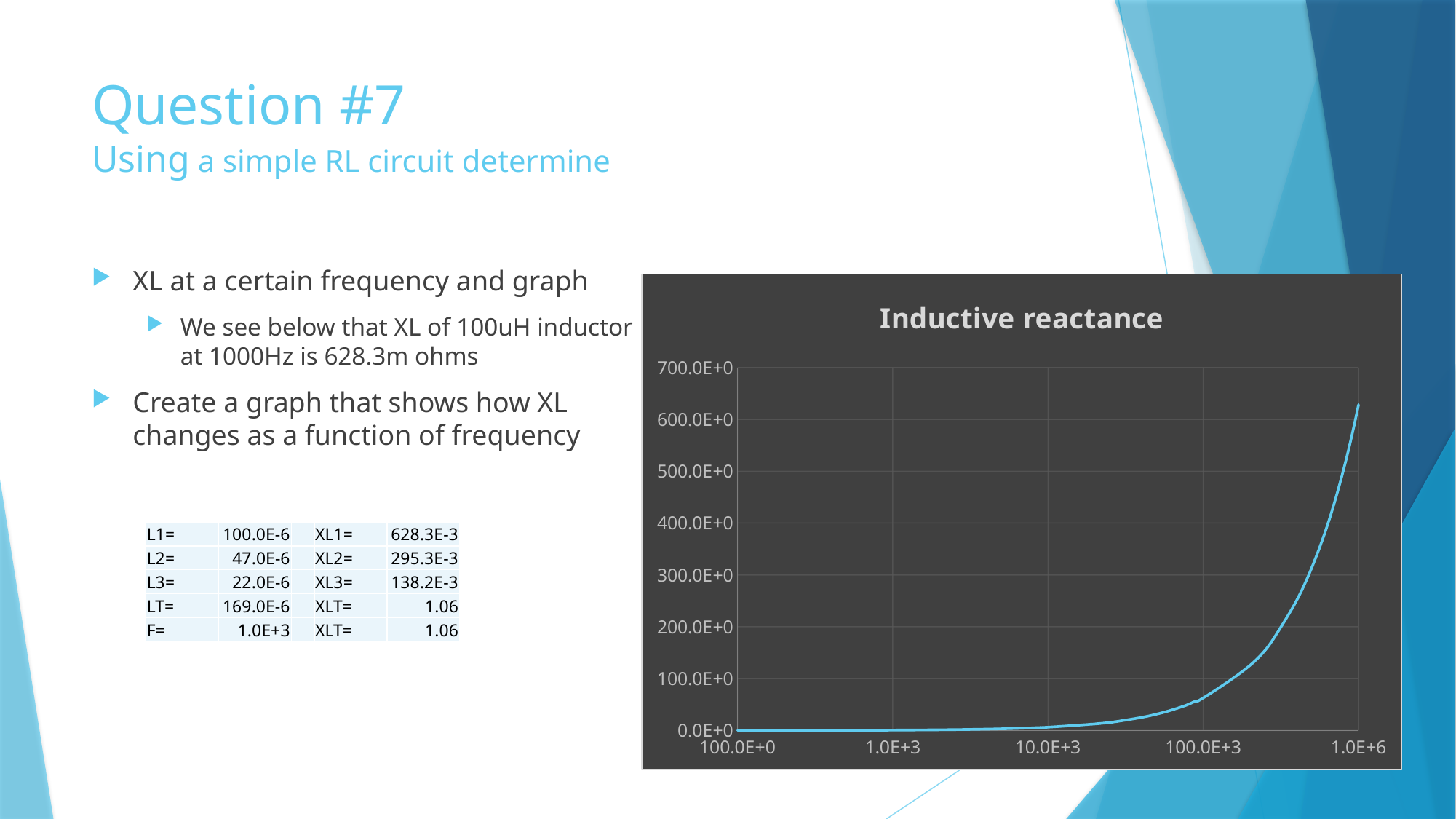
Is the value at 1.0E+6 on the x axis greater or less than 500.0E+0? greater How many tick labels are shown on the x axis? 5 Is the value at 10.0E+3 on the x axis greater or less than 100.0E+0? less What is the highest tick label on the y axis? 700.0E+0 Which has the larger value, the point at 100.0E+3 or the point at 1.0E+6? 1.0E+6 What is the title of the chart? Inductive reactance At which x-axis tick is the curve at its lowest value? 100.0E+0 Is the value at 1.0E+3 on the x axis greater or less than 100.0E+0? less At which x-axis tick does the curve reach its highest value? 1.0E+6 Does the plotted value rise or fall as frequency increases along the x axis? rise What kind of chart is shown on the slide? line chart